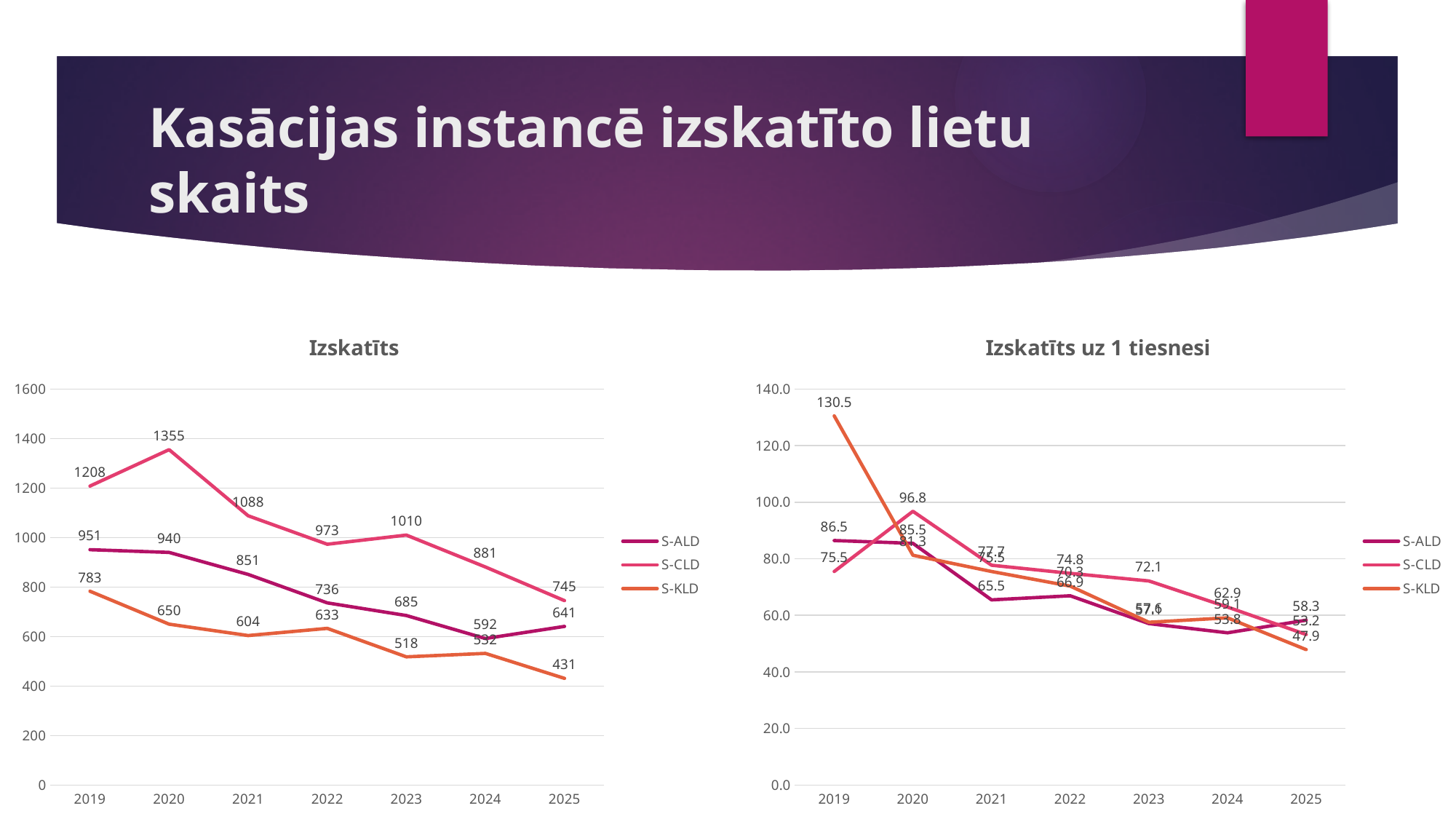
How many series does the legend of the 'Izskatīts uz 1 tiesnesi' chart list? 3 In the 'Izskatīts uz 1 tiesnesi' chart, what is the value for S-KLD in 2019? 130.5 In the 'Izskatīts uz 1 tiesnesi' chart, does the S-CLD line rise or fall from 2020 to 2025? fall In the 'Izskatīts' chart, what is the value for S-KLD in 2025? 431 What kind of chart is the 'Izskatīts uz 1 tiesnesi' chart? line chart How many years are shown on the x axis of the 'Izskatīts' chart? 7 In the 'Izskatīts' chart, which year has the larger S-ALD value, 2024 or 2025? 2025 In the 'Izskatīts' chart, in which year does S-CLD reach its highest value? 2020 In the 'Izskatīts' chart, what is the difference between the S-CLD values for 2019 and 2025? 463 In the 'Izskatīts' chart, in which year is the S-KLD value lowest? 2025 In the 'Izskatīts' chart, what is the value for S-CLD in 2020? 1355 In the 'Izskatīts uz 1 tiesnesi' chart, what is the difference between the S-CLD values for 2020 and 2025? 43.6